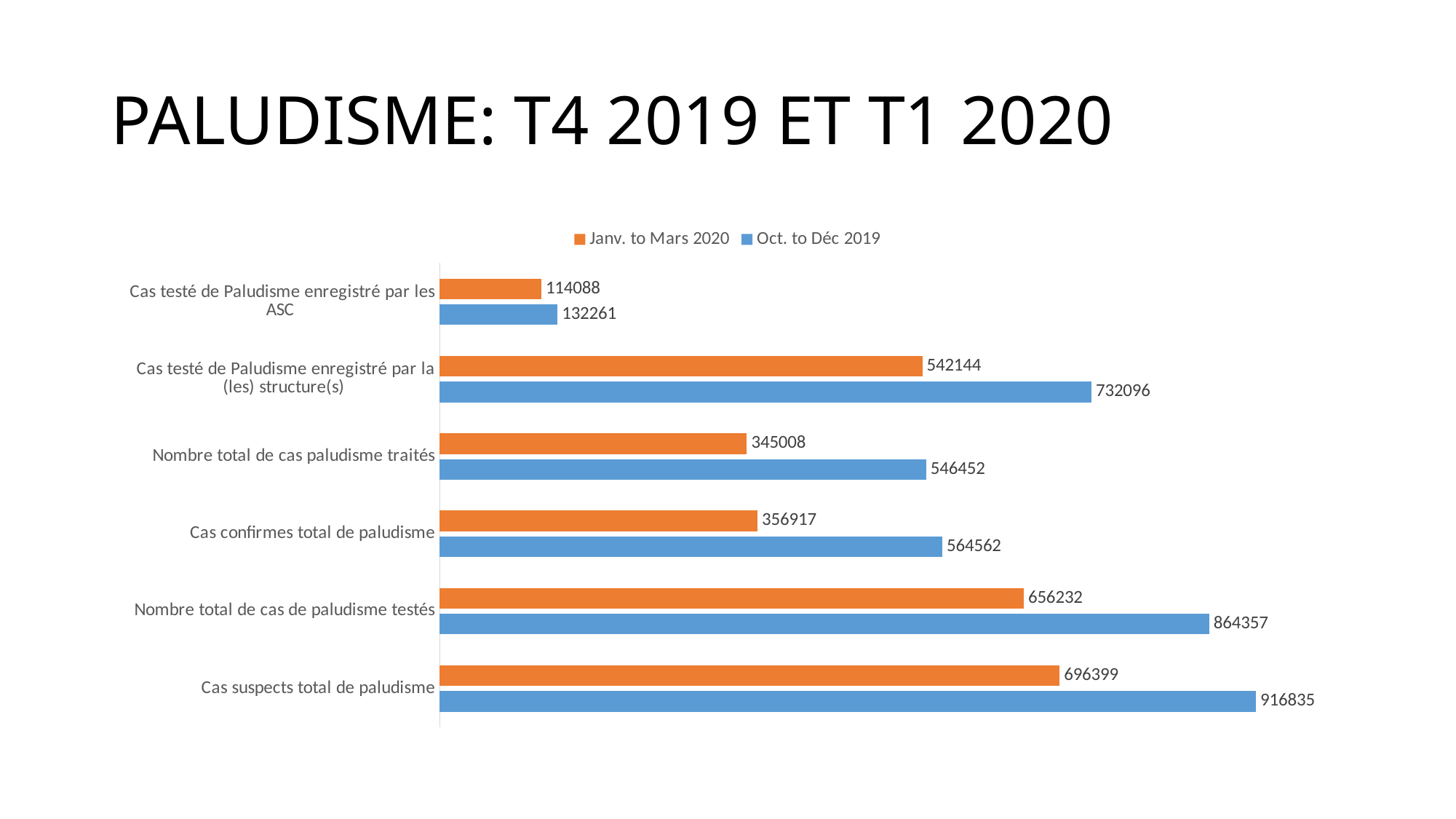
How many series does the legend list? 2 Which category has the lowest value in the Janv. to Mars 2020 series? Cas testé de Paludisme enregistré par les ASC Which category has the highest value in the Oct. to Déc 2019 series? Cas suspects total de paludisme What is the difference between the Oct. to Déc 2019 and Janv. to Mars 2020 values for "Cas suspects total de paludisme"? 220436 What is the value for "Cas suspects total de paludisme" in the Oct. to Déc 2019 series? 916835 What is the difference between the Oct. to Déc 2019 and Janv. to Mars 2020 values for "Cas testé de Paludisme enregistré par les ASC"? 18173 What kind of chart is shown on the slide? Bar chart What is the value for "Cas testé de Paludisme enregistré par la (les) structure(s)" in the Janv. to Mars 2020 series? 542144 How many categories are shown on the chart? 6 What is the value for "Nombre total de cas paludisme traités" in the Oct. to Déc 2019 series? 546452 For "Nombre total de cas de paludisme testés", which series has the larger value: Janv. to Mars 2020 or Oct. to Déc 2019? Oct. to Déc 2019 What is the value for "Cas testé de Paludisme enregistré par les ASC" in the Janv. to Mars 2020 series? 114088